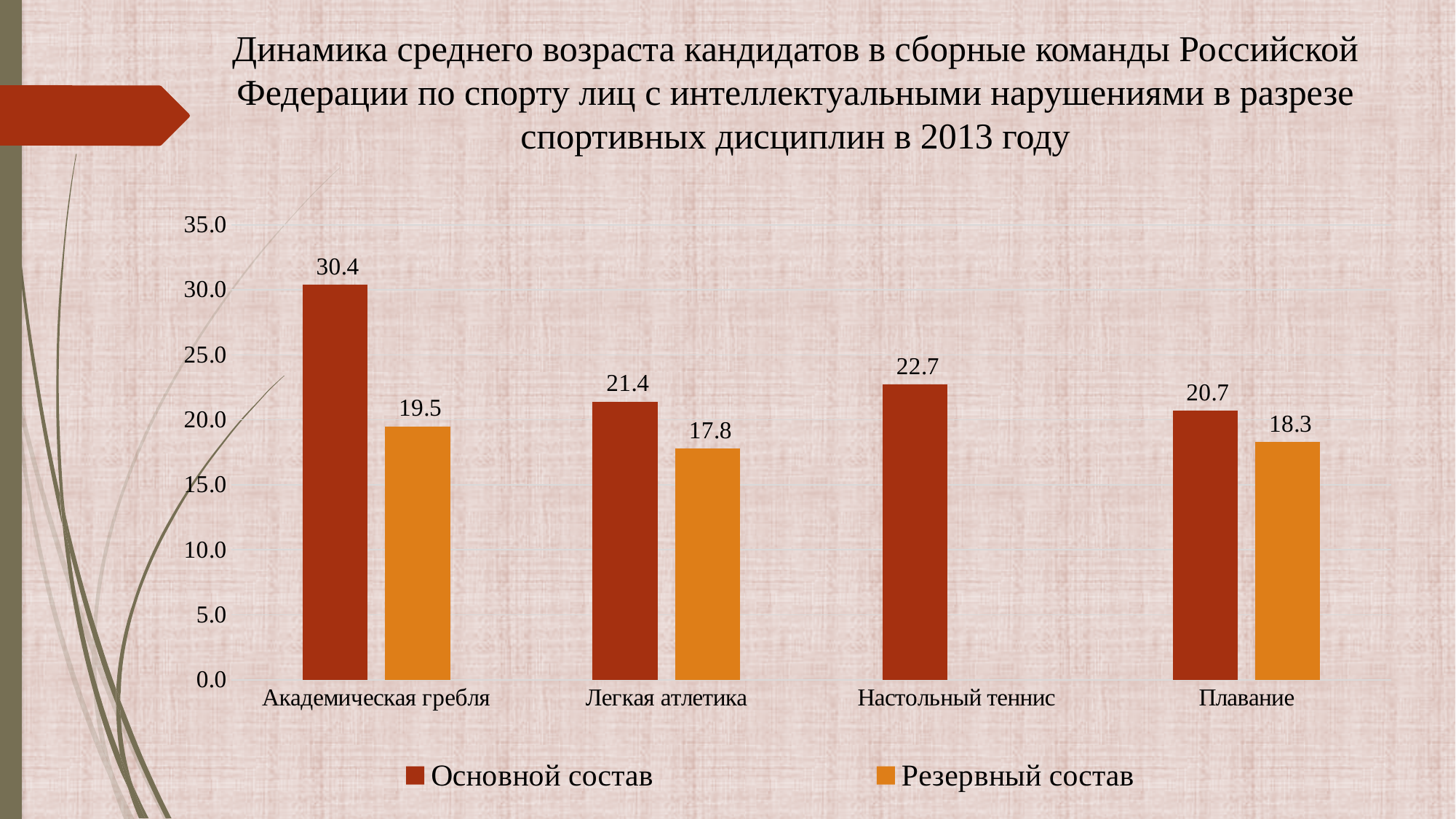
What is the value for Резервный состав in Легкая атлетика? 17.8 What is the difference between Основной состав and Резервный состав in Академическая гребля? 10.9 What is the value for Резервный состав in Плавание? 18.3 How many categories are shown on the x axis? 4 Which category has the lowest value for Резервный состав? Легкая атлетика How many series does the legend list? 2 What is the value for Основной состав in Академическая гребля? 30.4 Is the value for Основной состав in Настольный теннис greater or less than 25.0? less What kind of chart is shown on the slide? bar chart Which category has the highest value for Основной состав? Академическая гребля Which is larger: Основной состав in Легкая атлетика or Основной состав in Плавание? Легкая атлетика What is the value for Основной состав in Настольный теннис? 22.7